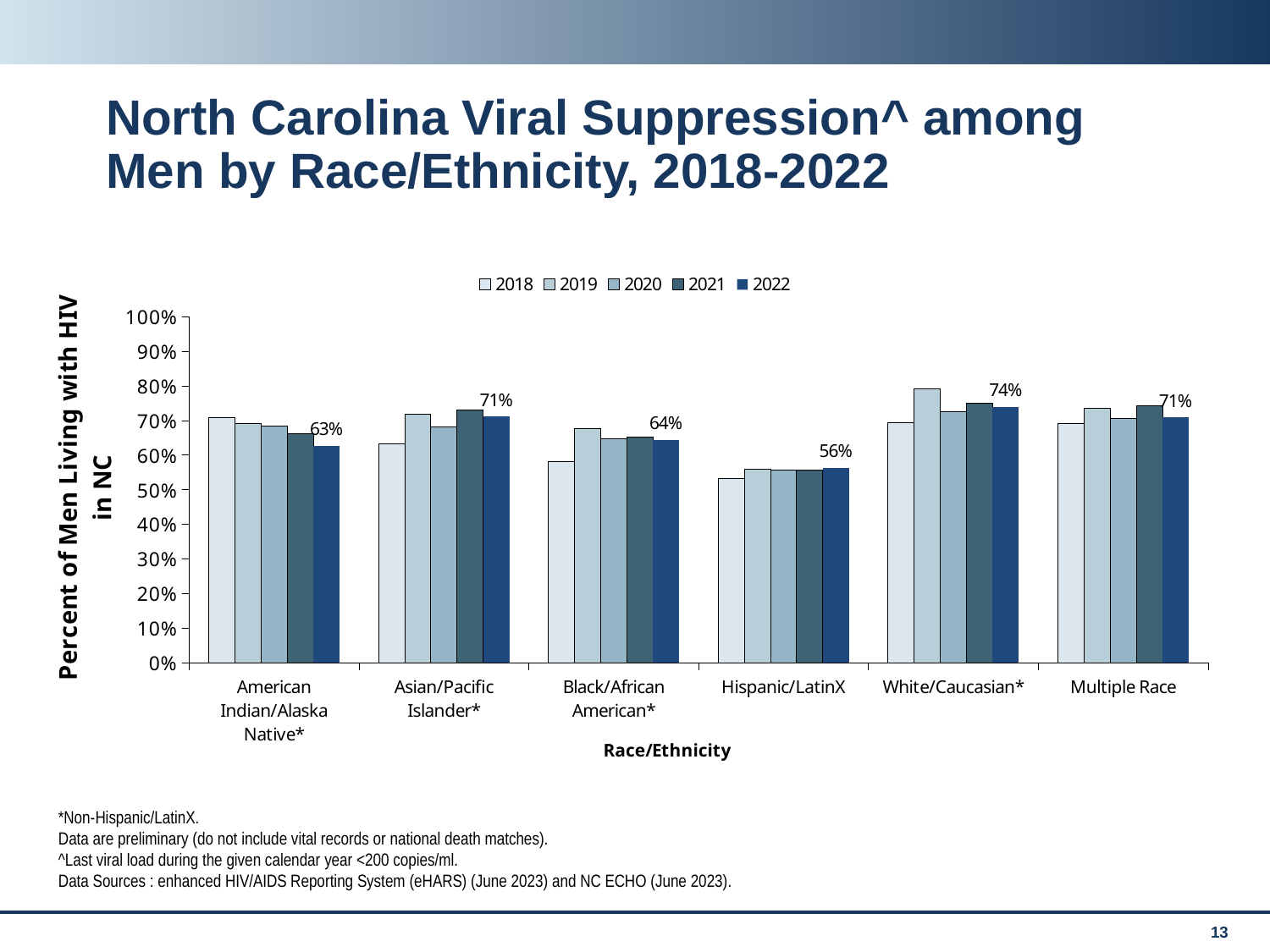
What is the difference between the 2022 values for White/Caucasian* and Hispanic/LatinX men? 18 percentage points How many race/ethnicity categories are shown on the x axis? 6 What is the 2022 value for men of Multiple Race? 71% What is the 2022 value for White/Caucasian* men? 74% In 2022, which is larger: the value for Asian/Pacific Islander* men or for American Indian/Alaska Native* men? Asian/Pacific Islander* Is the 2019 value for White/Caucasian* men greater or less than 70%? greater Which race/ethnicity group has the highest 2022 value? White/Caucasian* Which race/ethnicity group has the lowest 2022 value? Hispanic/LatinX Is the 2018 value for Hispanic/LatinX men greater or less than 60%? less What is the 2022 viral suppression value for Hispanic/LatinX men? 56% How many years (series) does the legend list? 5 What is the difference between the 2022 values for Asian/Pacific Islander* and Black/African American* men? 7 percentage points